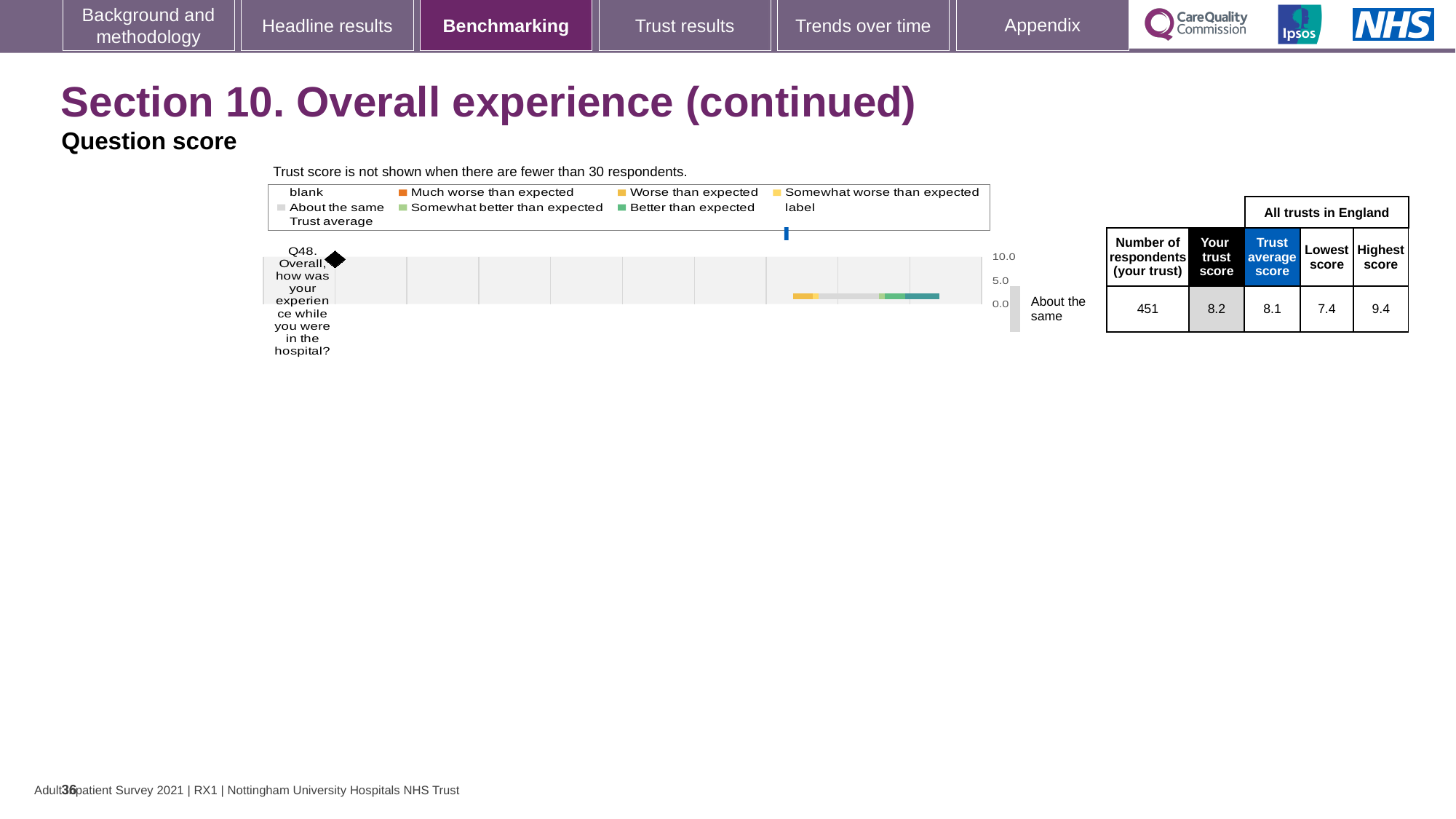
What is the trust average score for Q48 across all trusts in England? 8.1 What is the benchmarking rating shown next to the chart for Q48? About the same Which question is plotted on the benchmarking chart? Q48. Overall, how was your experience while you were in the hospital? What is the highest value shown on the chart's axis? 10.0 What is the highest score for Q48 across all trusts in England? 9.4 Which is larger for Q48, your trust score or the trust average score? Your trust score What is the number of respondents for your trust for Q48? 451 How many questions (categories) are plotted on the benchmarking chart? 1 What is the difference between the highest score and the lowest score for Q48 across all trusts in England? 2.0 What kind of chart is used to show the benchmarking result for Q48? bar chart What is your trust score for Q48? 8.2 What is the lowest score for Q48 across all trusts in England? 7.4